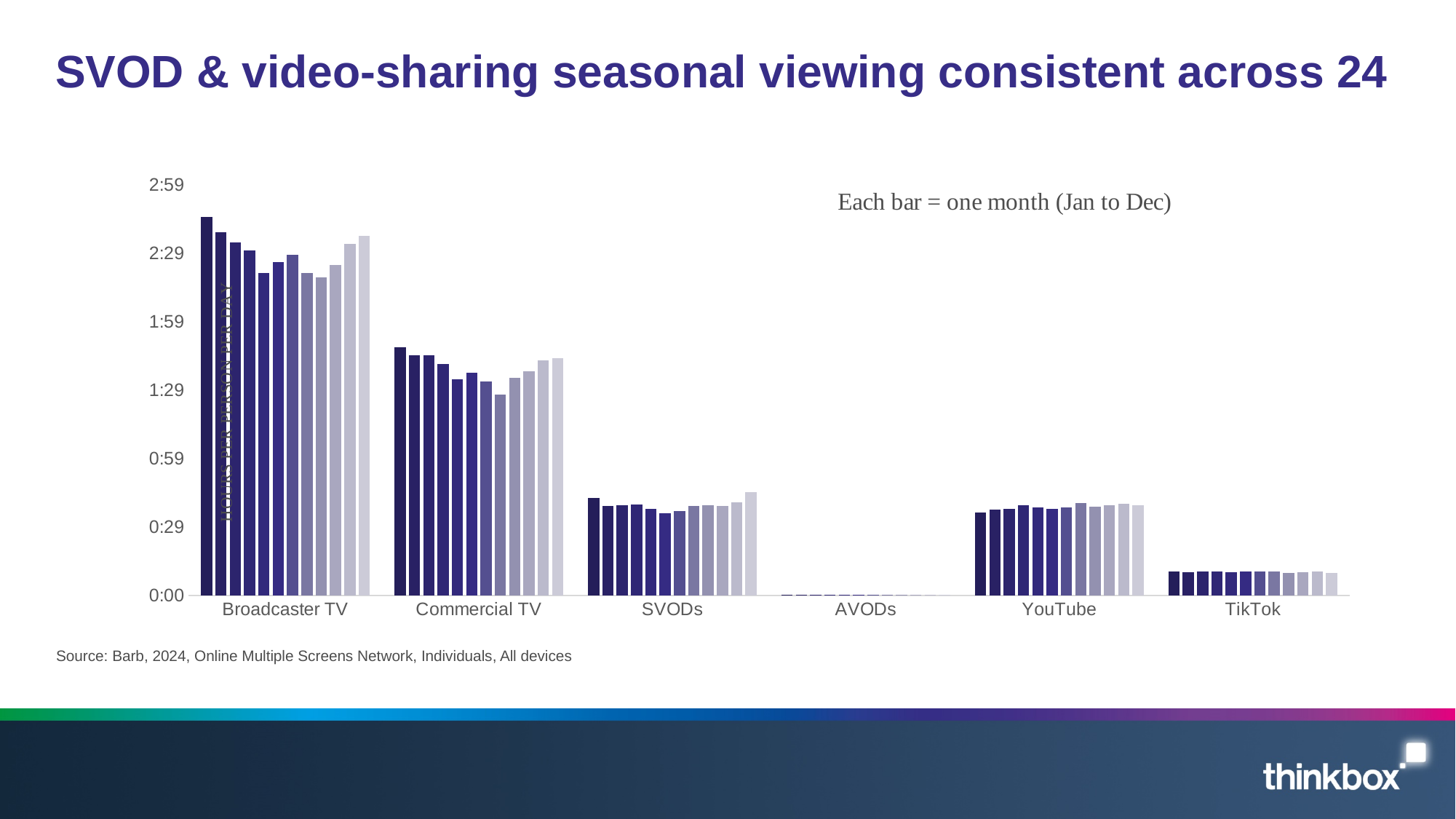
Are the values for YouTube greater or less than 0:59? less Which category has higher values, YouTube or TikTok? YouTube Are the values for TikTok greater or less than 0:29? less Which category has the lowest viewing values? AVODs Is the value for the first (January) Broadcaster TV bar greater or less than 2:29? greater Do the Broadcaster TV values rise or fall from January to August? fall How many categories are shown along the x axis? 6 According to the annotation on the chart, what does each bar represent? One month (Jan to Dec) Which category has the highest viewing values? Broadcaster TV Which category has higher values, Broadcaster TV or Commercial TV? Broadcaster TV What kind of chart is shown on the slide? Bar chart